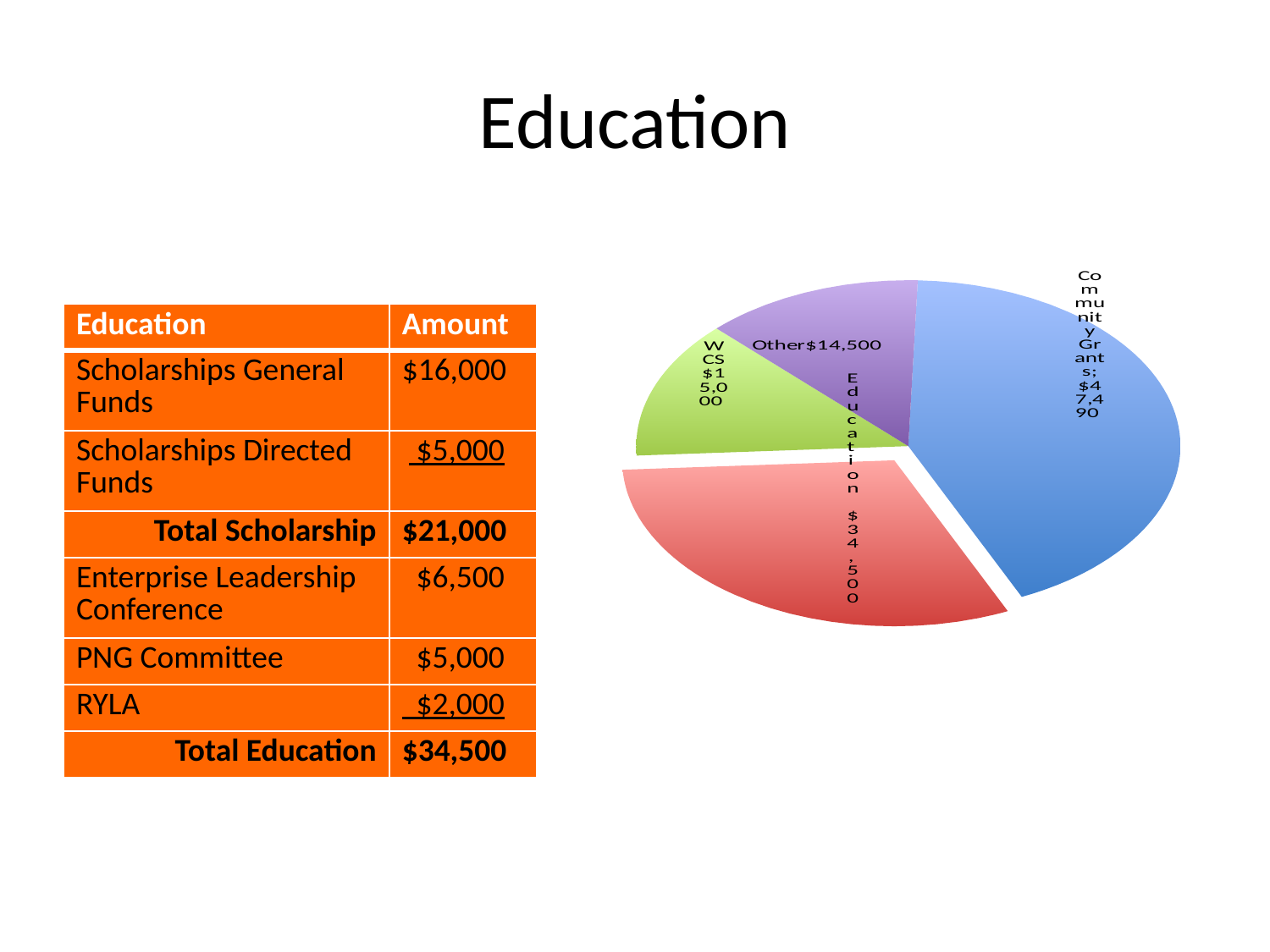
Which slice of the pie chart is the largest? Community Grants What is the value of the Other slice in the pie chart? $14,500 What is the difference between the Community Grants slice and the Education slice in the pie chart? $12,990 What is the difference between the Education slice and the WCS slice in the pie chart? $19,500 Which slice of the pie chart is pulled out (exploded) from the rest of the pie? Education What kind of chart is shown on the slide? pie chart What is the value of the Community Grants slice in the pie chart? $47,490 What is the value of the WCS slice in the pie chart? $15,000 How many slices does the pie chart have? 4 Which is larger in the pie chart, Education or WCS? Education Which slice of the pie chart is the smallest? Other What is the value of the Education slice in the pie chart? $34,500